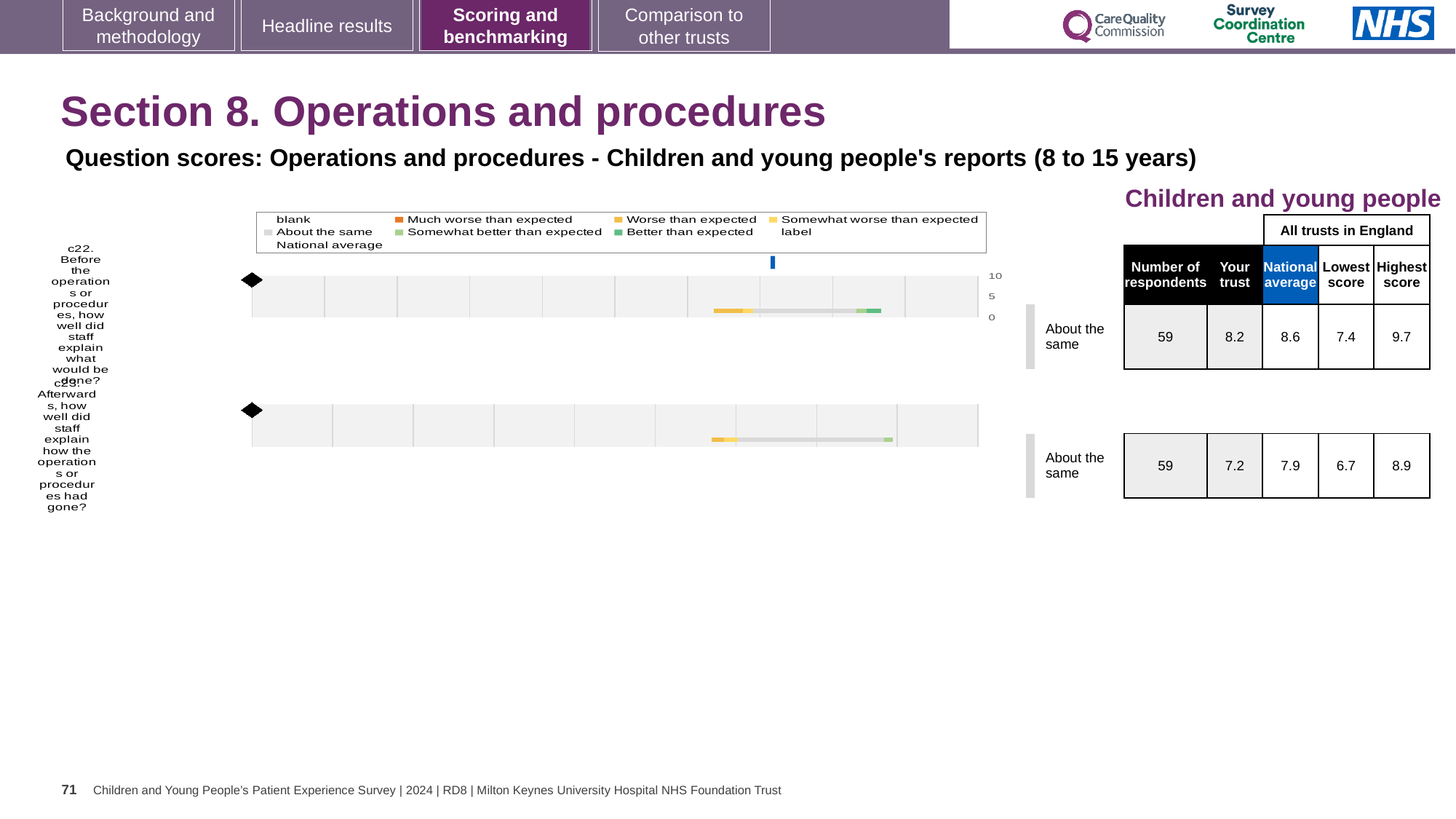
What benchmark category is shown for question c23? About the same What does the blue marker in the benchmarking charts represent, according to the legend? National average Which question has the higher 'Your trust' score, c22 or c23? c22 What type of chart is used to show the question scores for c22 and c23? bar chart What is the national average score for question c23 (Afterwards, how well did staff explain how the operations or procedures had gone?)? 7.9 How many respondents answered question c22? 59 What colour is used in the legend for 'Much worse than expected'? Orange What is the 'Your trust' score for question c22 (Before the operations or procedures, how well did staff explain what would be done?)? 8.2 For question c23, what is the difference between the highest score (8.9) and the lowest score (6.7) across all trusts in England? 2.2 For question c22, what is the difference between the highest score (9.7) and the lowest score (7.4) across all trusts in England? 2.3 How many survey questions are plotted in the benchmarking charts on this slide? 2 For question c22, which is larger: the 'Your trust' score or the national average? National average